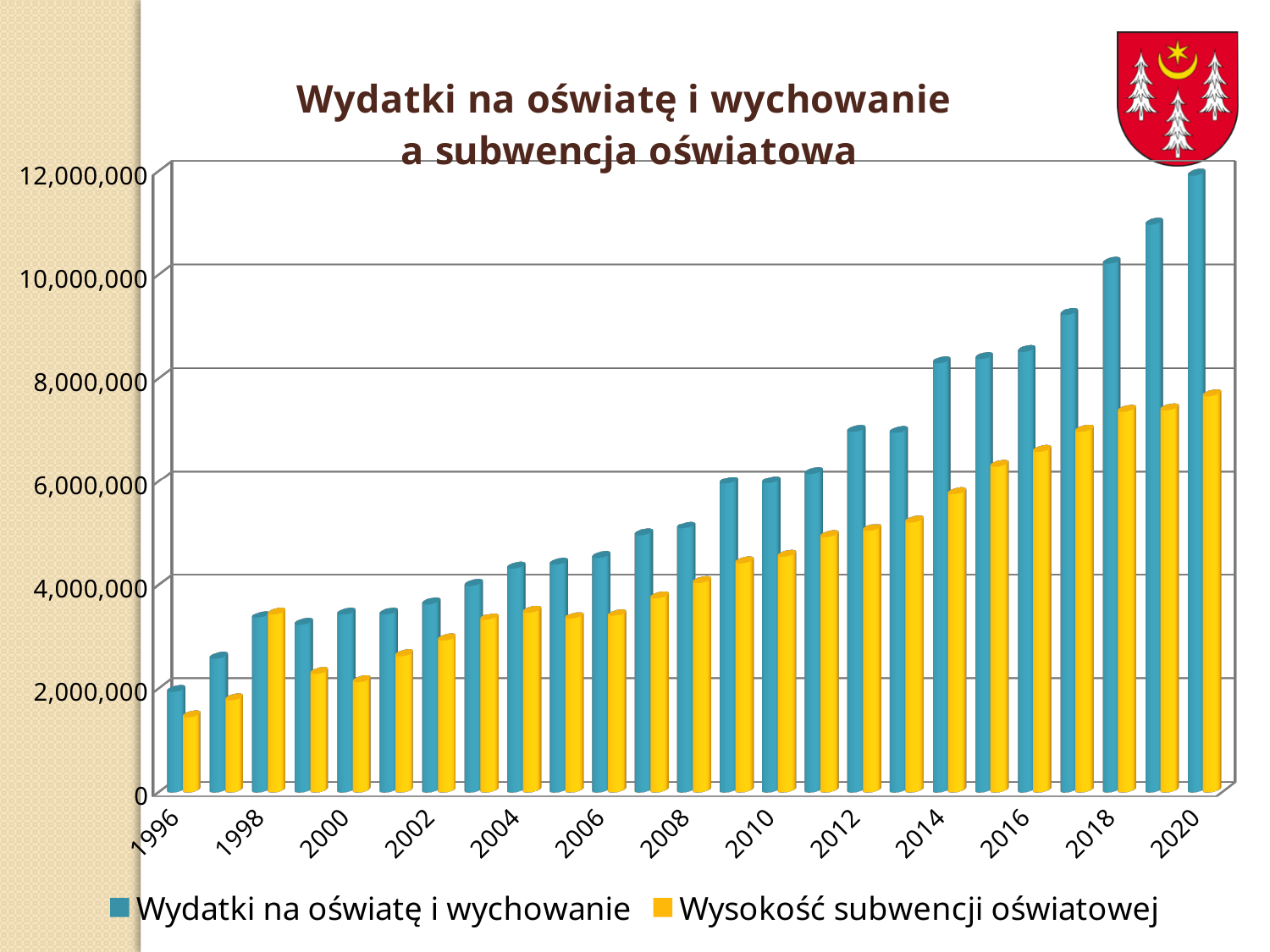
How many years are plotted along the x axis? 25 Is the value for Wysokość subwencji oświatowej in 2014 greater or less than 6,000,000? less Which year has the highest value for Wydatki na oświatę i wychowanie? 2020 How many series does the legend list? 2 What kind of chart is shown on the slide? bar chart Is the value for Wydatki na oświatę i wychowanie in 2012 greater or less than 8,000,000? less Do the values for Wydatki na oświatę i wychowanie generally rise or fall from 1996 to 2020? rise What colour are the bars for Wysokość subwencji oświatowej? yellow Is the value for Wydatki na oświatę i wychowanie in 2020 greater or less than 10,000,000? greater Which year has the lowest value for Wysokość subwencji oświatowej? 1996 In 2020, which series has the larger value: Wydatki na oświatę i wychowanie or Wysokość subwencji oświatowej? Wydatki na oświatę i wychowanie